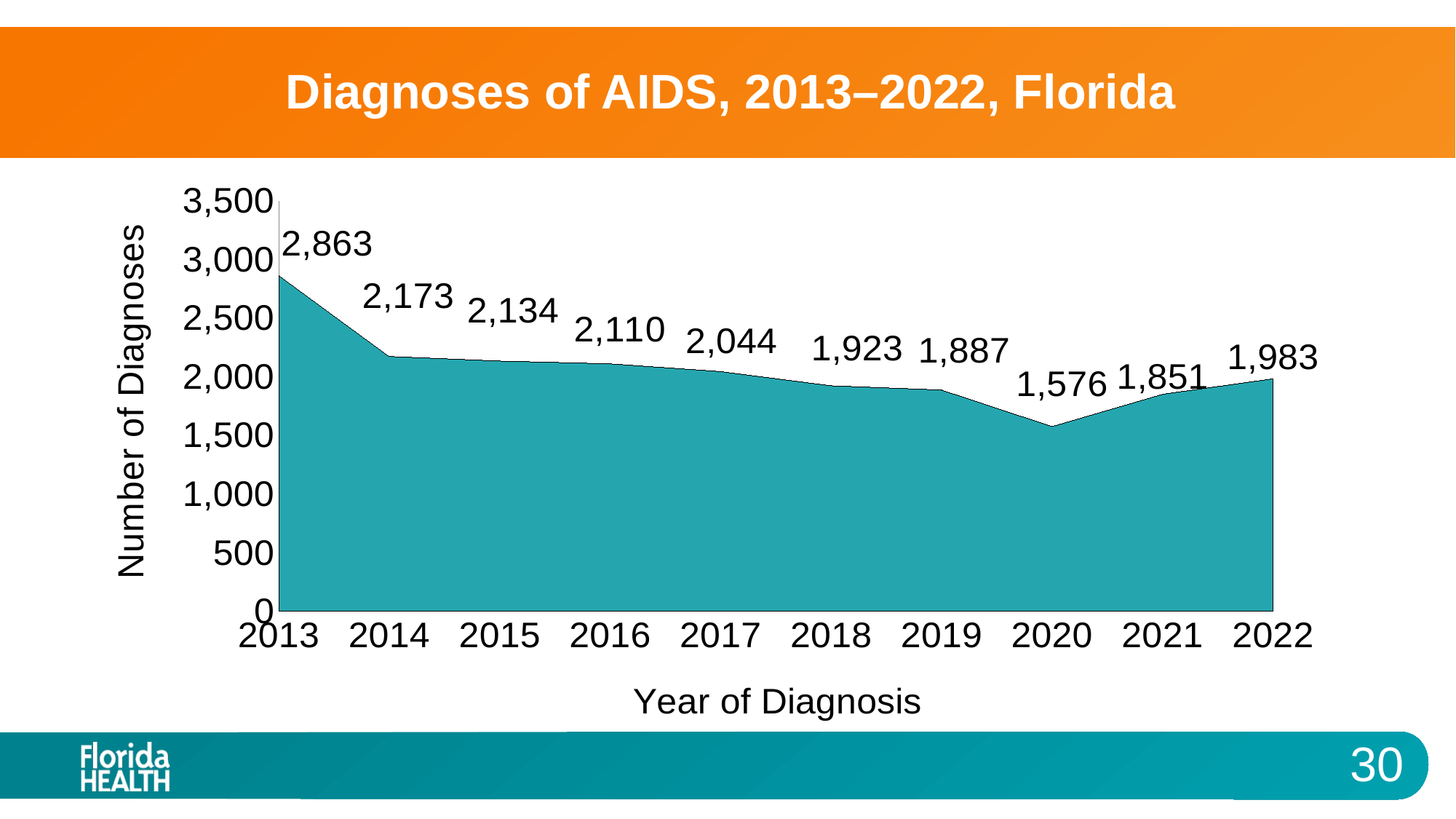
What is the number of diagnoses shown for 2022? 1,983 Which year has the lowest number of diagnoses? 2020 What is the difference in diagnoses between 2013 and 2014? 690 What is the number of diagnoses shown for 2020? 1,576 Which year had more diagnoses, 2018 or 2021? 2018 What kind of chart is shown on the slide? Area chart Which year has the highest number of diagnoses? 2013 What is the title of the chart? Diagnoses of AIDS, 2013–2022, Florida How many years are plotted on the x axis? 10 How many AIDS diagnoses were there in Florida in 2013? 2,863 Is the value for 2019 greater or less than 2,000? less What is the difference in diagnoses between 2022 and 2020? 407